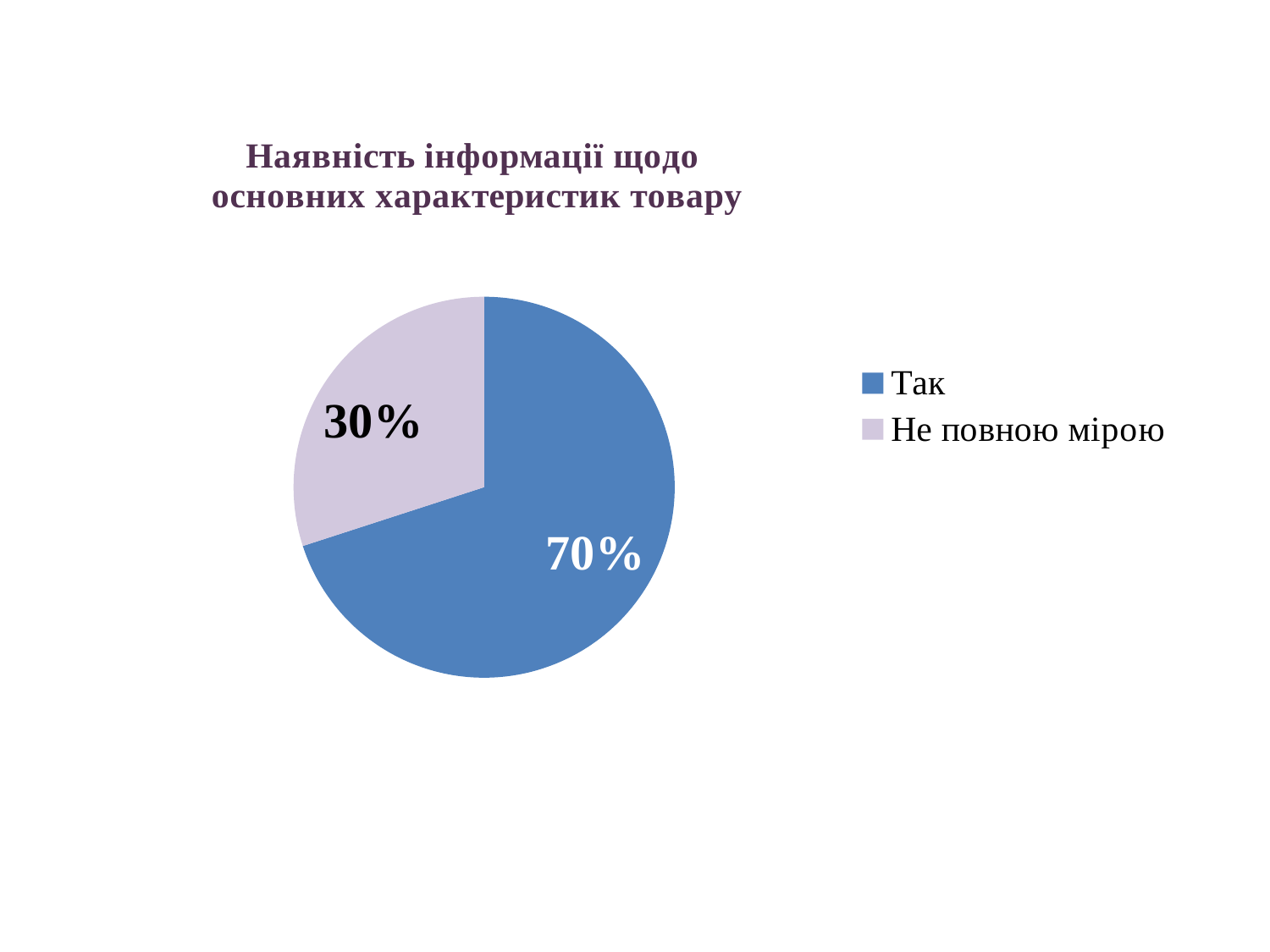
How many slices does the pie chart have? 2 How many entries does the legend list? 2 Which category has the largest slice of the pie? Так What is the title of the chart? Наявність інформації щодо основних характеристик товару What is the difference in percentage points between the "Так" and "Не повною мірою" slices? 40% What share of the pie does the "Не повною мірою" slice represent? 30% What share of the pie does the "Так" slice represent? 70% What kind of chart is shown on the slide? pie chart Which category has the smallest slice of the pie? Не повною мірою What colour is the "Так" slice? blue Which is larger, the "Так" slice or the "Не повною мірою" slice? Так